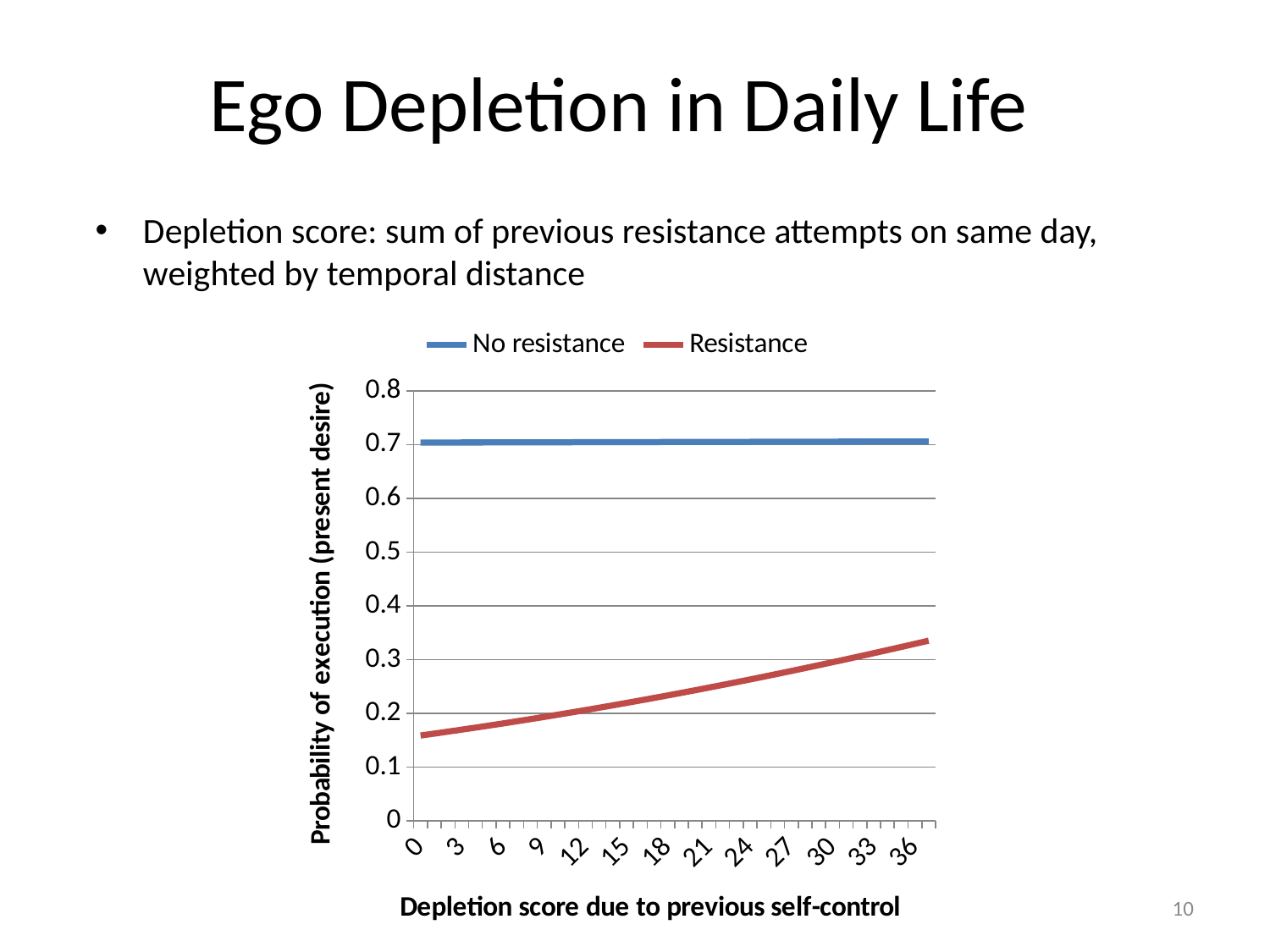
How many series does the chart's legend list? 2 Does the No resistance series rise, fall, or stay roughly flat as the depletion score increases? stay roughly flat Does the Resistance series rise or fall as the depletion score increases along the x axis? rise Is the value for the No resistance series at a depletion score of 0 greater or less than 0.6? greater Which series has the higher probability of execution at a depletion score of 36, No resistance or Resistance? No resistance What is the title of the chart's x axis? Depletion score due to previous self-control Is the value for the Resistance series at a depletion score of 0 greater or less than 0.2? less What kind of chart is shown on the slide? line chart Which series has the higher probability of execution at a depletion score of 0, No resistance or Resistance? No resistance Is the value for the Resistance series at a depletion score of 36 greater or less than 0.4? less Which two series are listed in the chart's legend? No resistance and Resistance